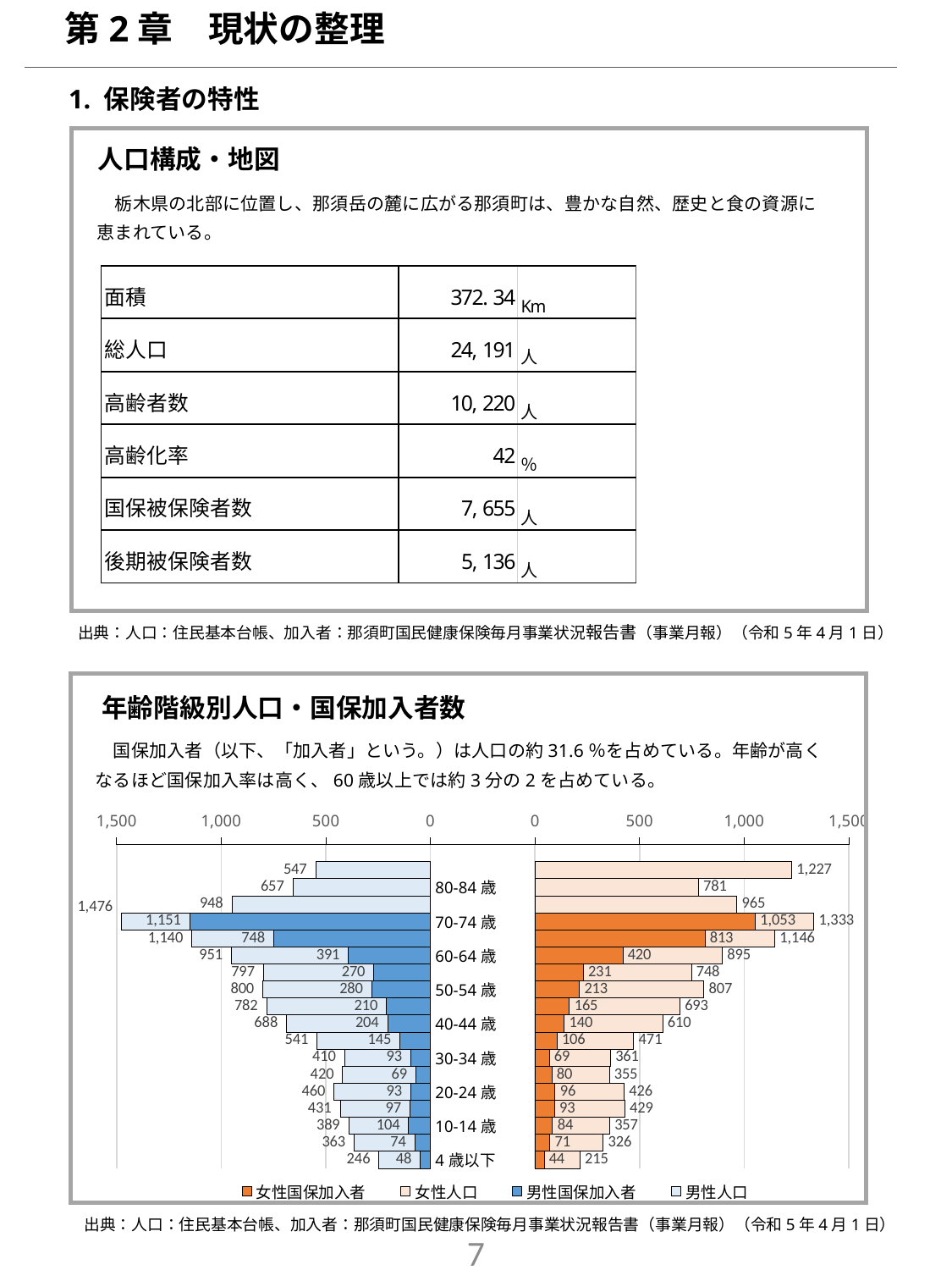
In the 年齢階級別人口・国保加入者数 chart, what is the 男性人口 value for the 4歳以下 age group? 246 In the 年齢階級別人口・国保加入者数 chart, what is the 女性人口 value for the 80-84歳 age group? 781 How many series does the legend of the 年齢階級別人口・国保加入者数 chart list? 4 In the 年齢階級別人口・国保加入者数 chart, is the 男性人口 value for the 40-44歳 age group greater or less than 500? greater What kind of chart is the 年齢階級別人口・国保加入者数 chart? bar chart In the 年齢階級別人口・国保加入者数 chart, for the 70-74歳 age group, which is larger: 男性国保加入者 or 女性国保加入者? 男性国保加入者 In the 年齢階級別人口・国保加入者数 chart, what is the 女性国保加入者 value for the 4歳以下 age group? 44 In the 年齢階級別人口・国保加入者数 chart, which age group has the highest 男性人口? 70-74歳 In the 年齢階級別人口・国保加入者数 chart, what is the 男性国保加入者 value for the 70-74歳 age group? 1,151 In the 年齢階級別人口・国保加入者数 chart, what is the 女性国保加入者 value for the 60-64歳 age group? 420 In the 年齢階級別人口・国保加入者数 chart, what is the difference between 男性人口 and 男性国保加入者 for the 60-64歳 age group? 560 In the 年齢階級別人口・国保加入者数 chart, what is the difference between 女性人口 and 女性国保加入者 for the 50-54歳 age group? 594